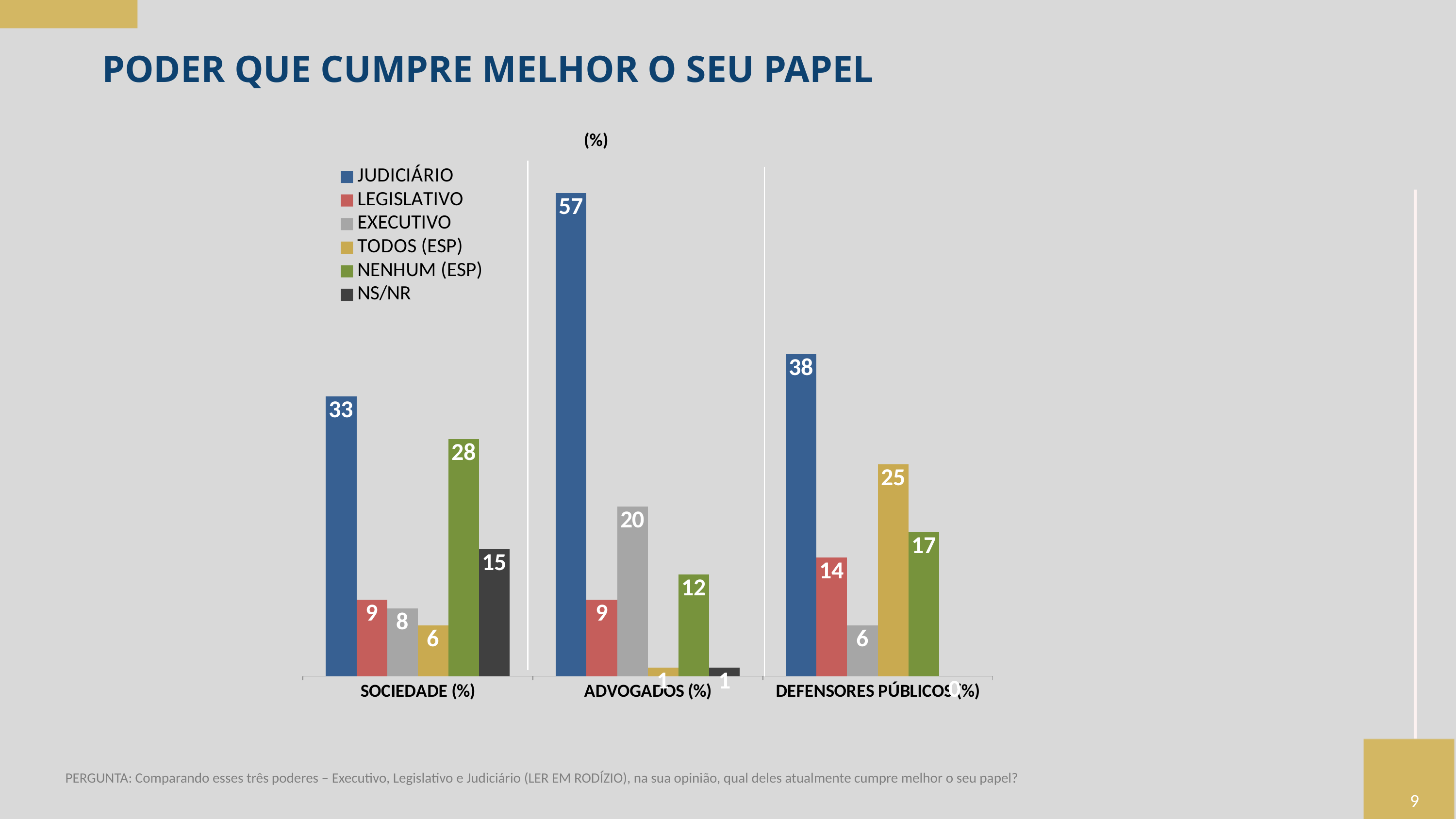
Which group has the highest value for JUDICIÁRIO? ADVOGADOS (%) How many groups are shown on the x axis? 3 What is the value for EXECUTIVO in the ADVOGADOS (%) group? 20 What kind of chart is shown on the slide? Bar chart Which is larger: NENHUM (ESP) for SOCIEDADE (%) or NENHUM (ESP) for DEFENSORES PÚBLICOS (%)? SOCIEDADE (%) What is the value for NENHUM (ESP) in the SOCIEDADE (%) group? 28 What is the value for TODOS (ESP) in the DEFENSORES PÚBLICOS (%) group? 25 What is the value for JUDICIÁRIO in the ADVOGADOS (%) group? 57 What is the difference between the JUDICIÁRIO values for ADVOGADOS (%) and SOCIEDADE (%)? 24 What is the title of the slide? PODER QUE CUMPRE MELHOR O SEU PAPEL How many series does the legend list? 6 Which series has the lowest value in the SOCIEDADE (%) group? TODOS (ESP)